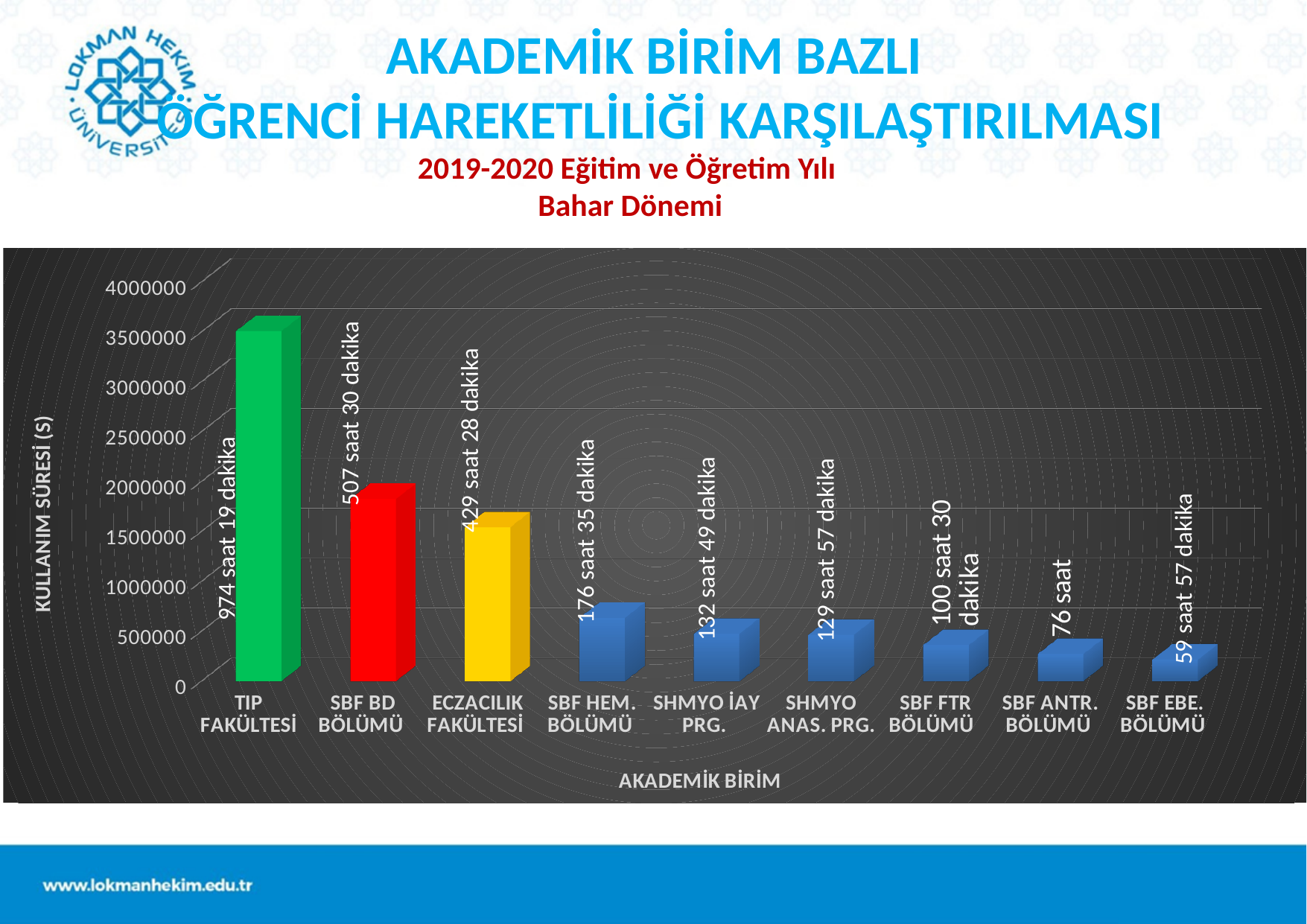
What type of chart is shown on the slide? Bar chart What is the value shown for SBF BD BÖLÜMÜ? 507 saat 30 dakika What is the value shown for TIP FAKÜLTESİ? 974 saat 19 dakika Which academic unit has the highest usage time? TIP FAKÜLTESİ What is the value shown for SBF EBE. BÖLÜMÜ? 59 saat 57 dakika Is the value for SBF EBE. BÖLÜMÜ greater or less than 500000 on the y axis? less Which academic unit has the lowest usage time? SBF EBE. BÖLÜMÜ What is the value shown for ECZACILIK FAKÜLTESİ? 429 saat 28 dakika How many academic units are shown on the x axis? 9 Is the value for TIP FAKÜLTESİ greater or less than 3000000 on the y axis? greater Which has a larger value, SBF HEM. BÖLÜMÜ or SBF FTR BÖLÜMÜ? SBF HEM. BÖLÜMÜ What is the value shown for SBF ANTR. BÖLÜMÜ? 76 saat